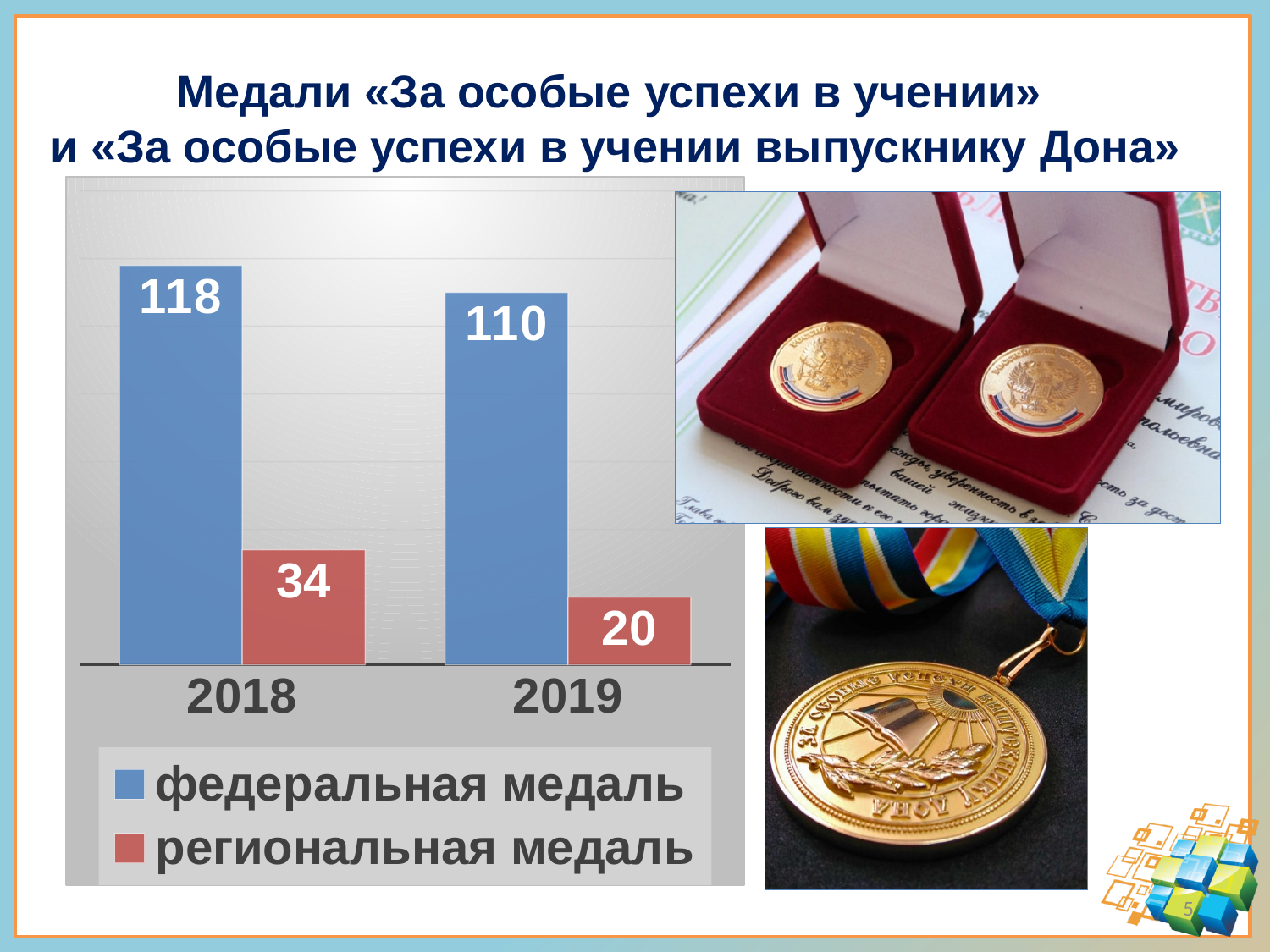
How many series does the legend list? 2 What is the value for федеральная медаль in 2019? 110 Which year has the higher value for федеральная медаль? 2018 What is the value for федеральная медаль in 2018? 118 Which is larger: федеральная медаль in 2019 or региональная медаль in 2018? федеральная медаль in 2019 What kind of chart is shown on the slide? bar chart What is the value for региональная медаль in 2019? 20 What is the difference between региональная медаль in 2018 and in 2019? 14 Which bar has the lowest value on the chart? региональная медаль in 2019 What is the difference between федеральная медаль in 2018 and in 2019? 8 What is the value for региональная медаль in 2018? 34 How many years are shown on the x axis of the chart? 2